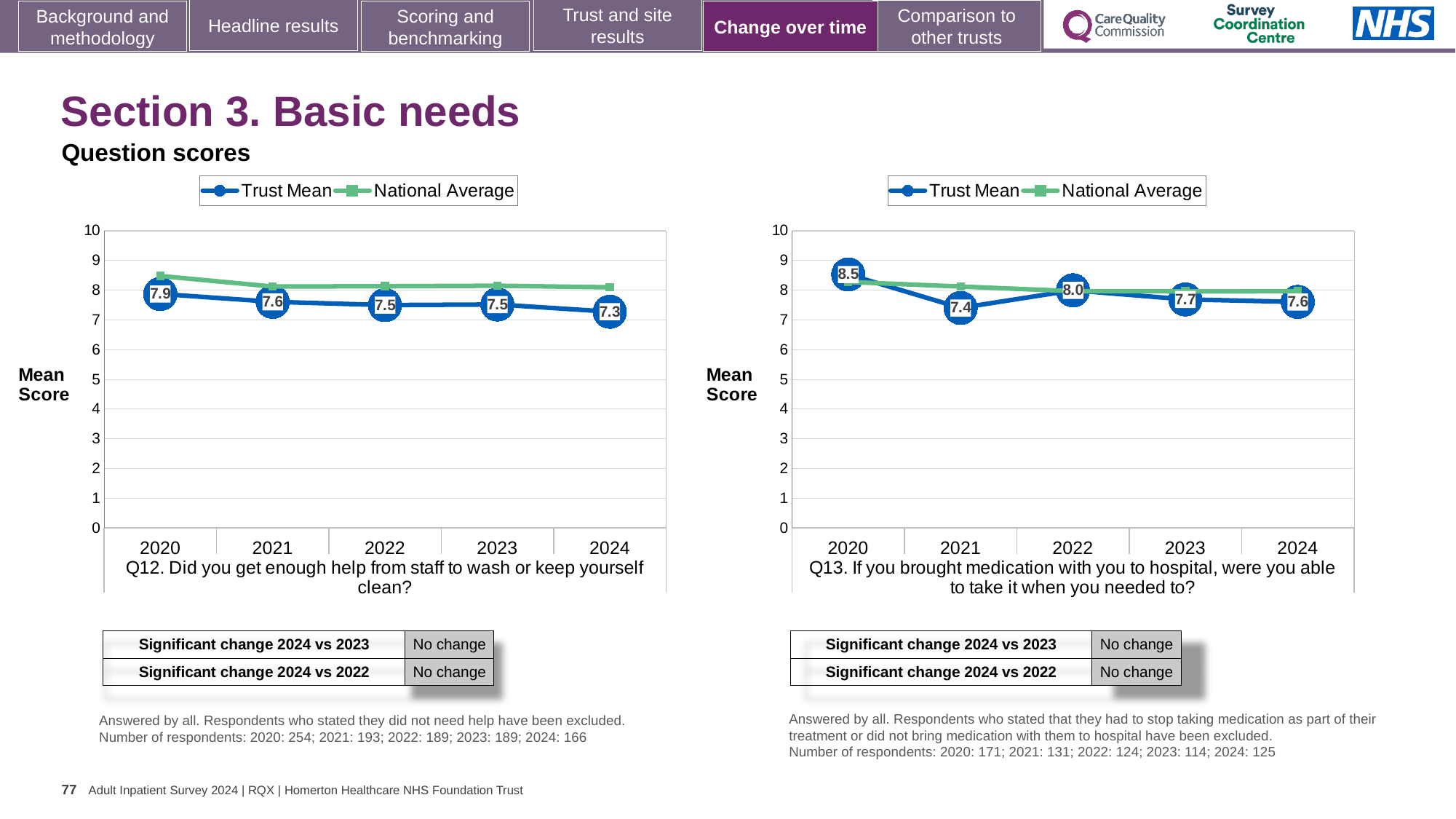
In the Q12 chart (left), what is the difference between the Trust Mean scores for 2020 and 2024? 0.6 In the Q12 chart (left), what is the Trust Mean score for 2024? 7.3 How many series does the legend of the Q13 chart (right) list? 2 In the Q12 chart (left), which year has the lowest Trust Mean score? 2024 In the Q13 chart (right), what is the difference between the Trust Mean scores for 2020 and 2021? 1.1 In the Q13 chart (right), is the Trust Mean score for 2022 higher or lower than for 2023? higher In the Q12 chart (left), what is the Trust Mean score for 2020? 7.9 In the Q12 chart (left), is the National Average value for 2020 greater or less than 8? greater How many years are plotted on the x axis of the Q12 chart (left)? 5 In the Q13 chart (right), which year has the highest Trust Mean score? 2020 What type of chart is used for Q12 (left)? line chart In the Q13 chart (right), what is the Trust Mean score for 2021? 7.4